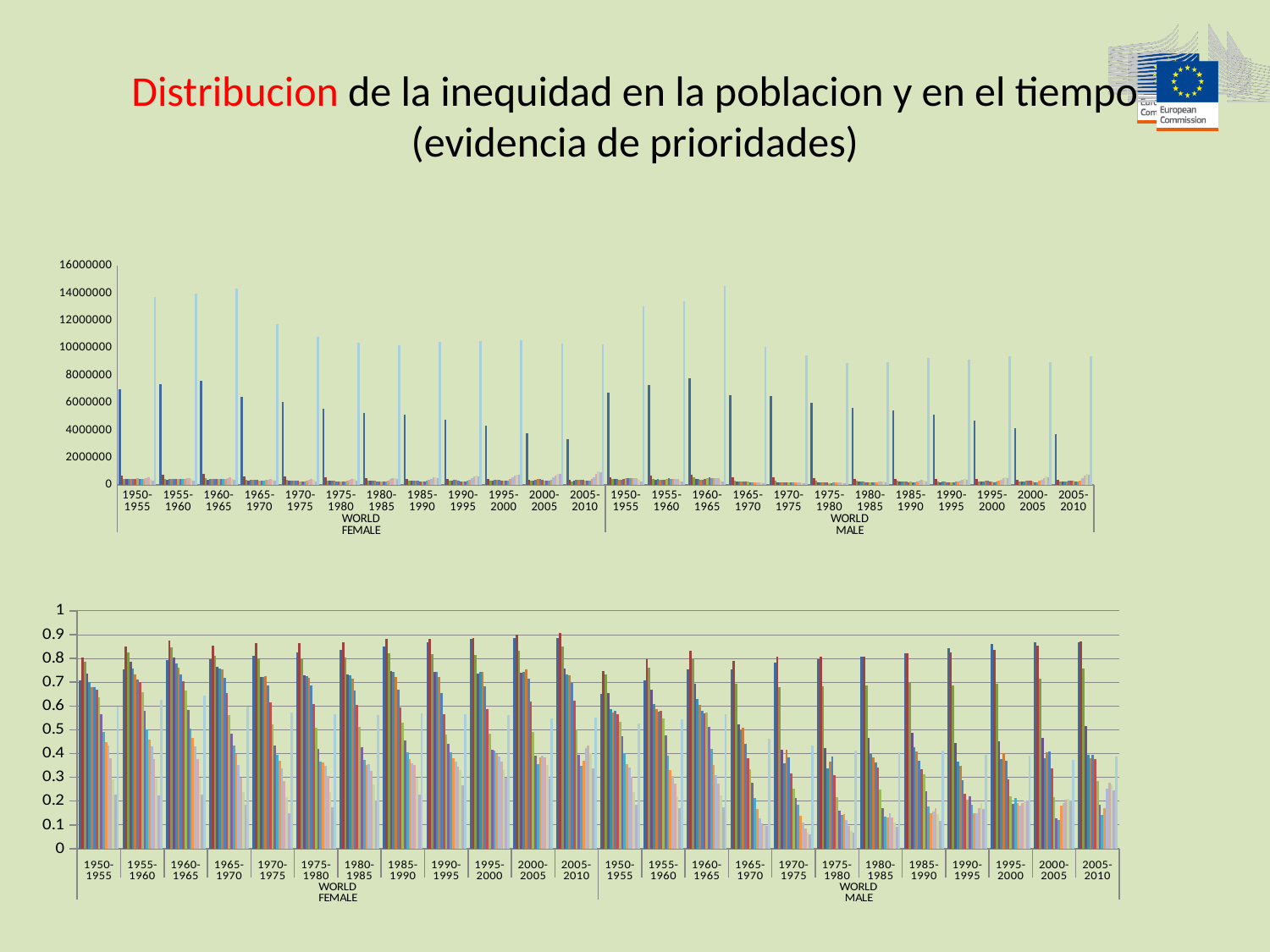
In the top chart, is the first (dark blue) bar for WORLD FEMALE 2005-2010 greater or less than 4000000? less In the top chart, is the first (dark blue) bar for WORLD MALE 1960-1965 greater or less than 6000000? greater What kind of chart is the top chart on the slide? bar chart In the bottom chart, is the tallest bar for WORLD MALE 2005-2010 greater or less than 0.8? greater What are the two group labels shown along the x axis of the bottom chart? WORLD FEMALE and WORLD MALE In the top chart, does the first (dark blue) bar for WORLD FEMALE rise or fall from 1950-1955 to 2005-2010? fall What is the highest value shown on the y axis of the top chart? 16000000 In the bottom chart, how many category groups (time periods) are shown in total across WORLD FEMALE and WORLD MALE? 24 In the top chart, how many time periods are shown under the WORLD FEMALE group? 12 What kind of chart is the bottom chart on the slide? bar chart